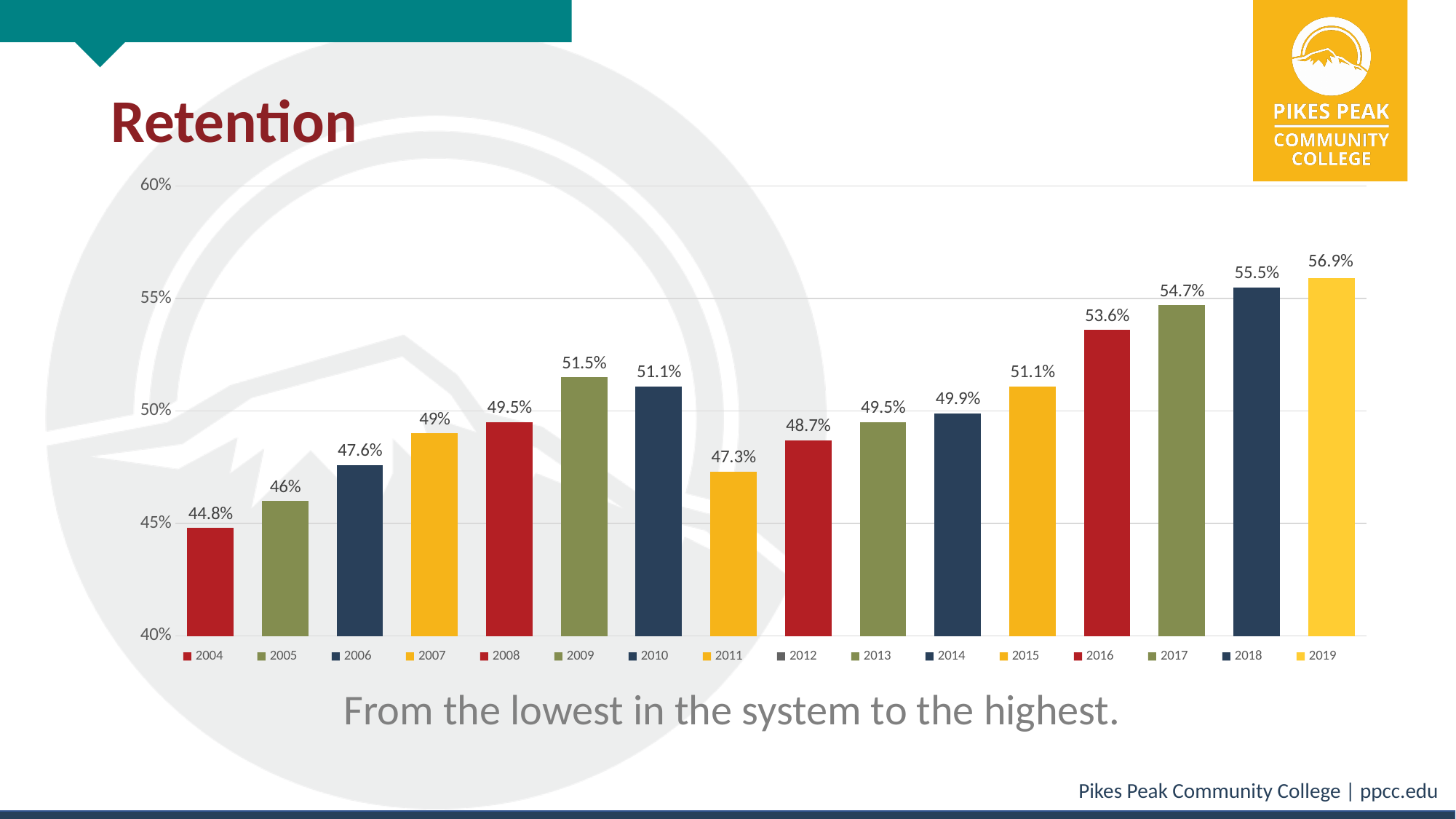
How many entries does the legend list? 16 What is the retention value for 2011? 47.3% Which year has the lowest retention value? 2004 What kind of chart is shown on the slide? Bar chart Which is larger, the retention value for 2010 or for 2012? 2010 Which year has the highest retention value? 2019 What is the retention value for 2004? 44.8% What is the retention value for 2016? 53.6% Is the retention value for 2017 greater or less than 50%? greater What is the difference between the retention values for 2009 and 2011? 4.2% What is the difference between the retention values for 2019 and 2004? 12.1% How many bars are plotted in the chart? 16